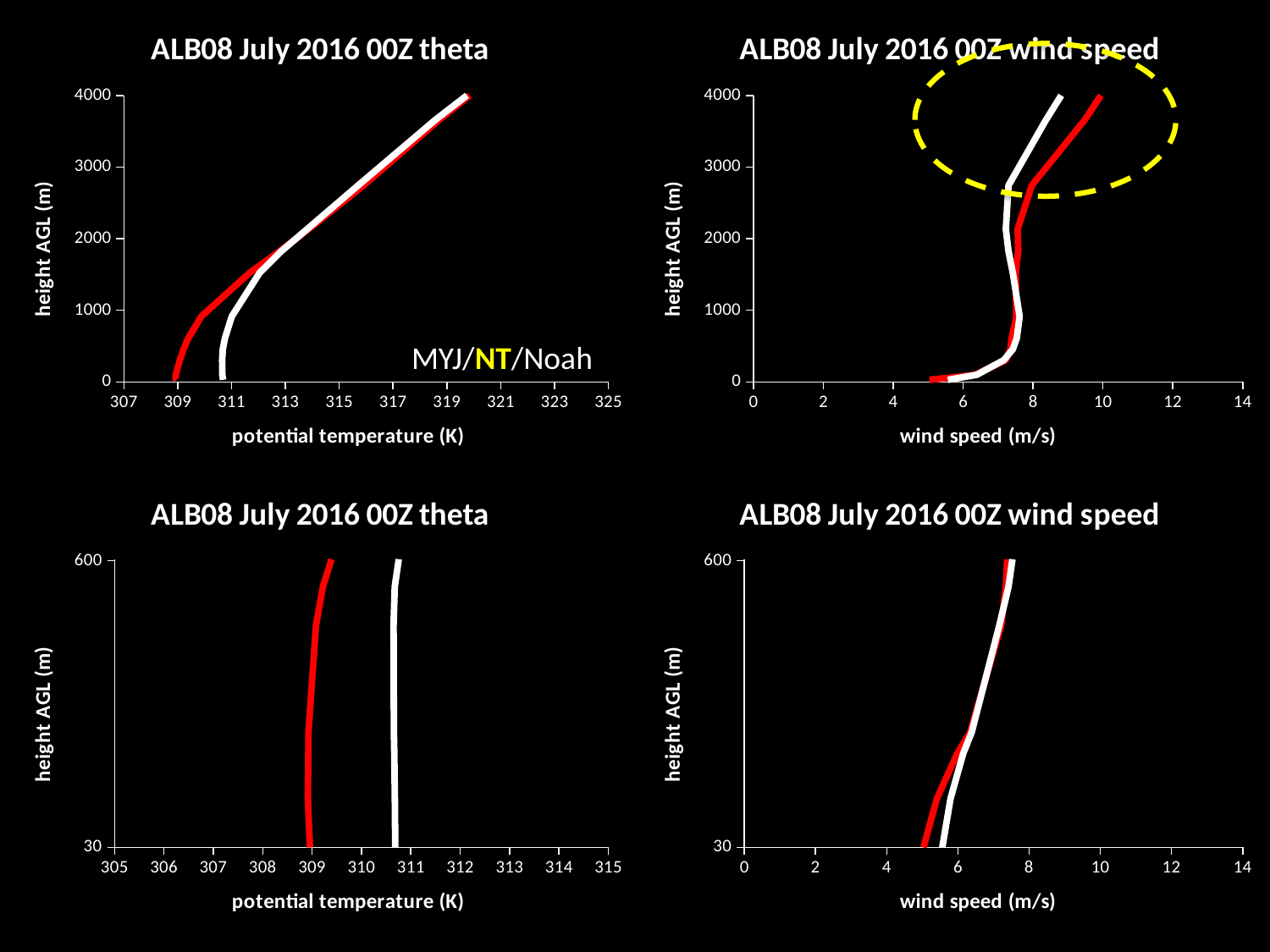
What is the x-axis label of the top-right chart? wind speed (m/s) How many charts are shown on the slide? 4 In the top-left theta chart, is the red line's potential temperature at 0 m height greater or less than 311 K? less In the bottom-left theta chart, which line lies at a higher potential temperature, the red line or the white line? white line In the top-right wind speed chart, is the red line's wind speed at 4000 m greater or less than 8 m/s? greater In the top-right wind speed chart, is the red line's wind speed at 0 m greater or less than 6 m/s? less What kind of chart is the top-left 'ALB08 July 2016 00Z theta' chart? line chart In the bottom-right wind speed chart, does wind speed rise or fall as height increases from 30 m to 600 m? rise In the top-left theta chart, does potential temperature rise or fall as height increases from 0 to 4000 m? rise In the top-right wind speed chart, which line has the higher wind speed at 4000 m height, the red line or the white line? red line